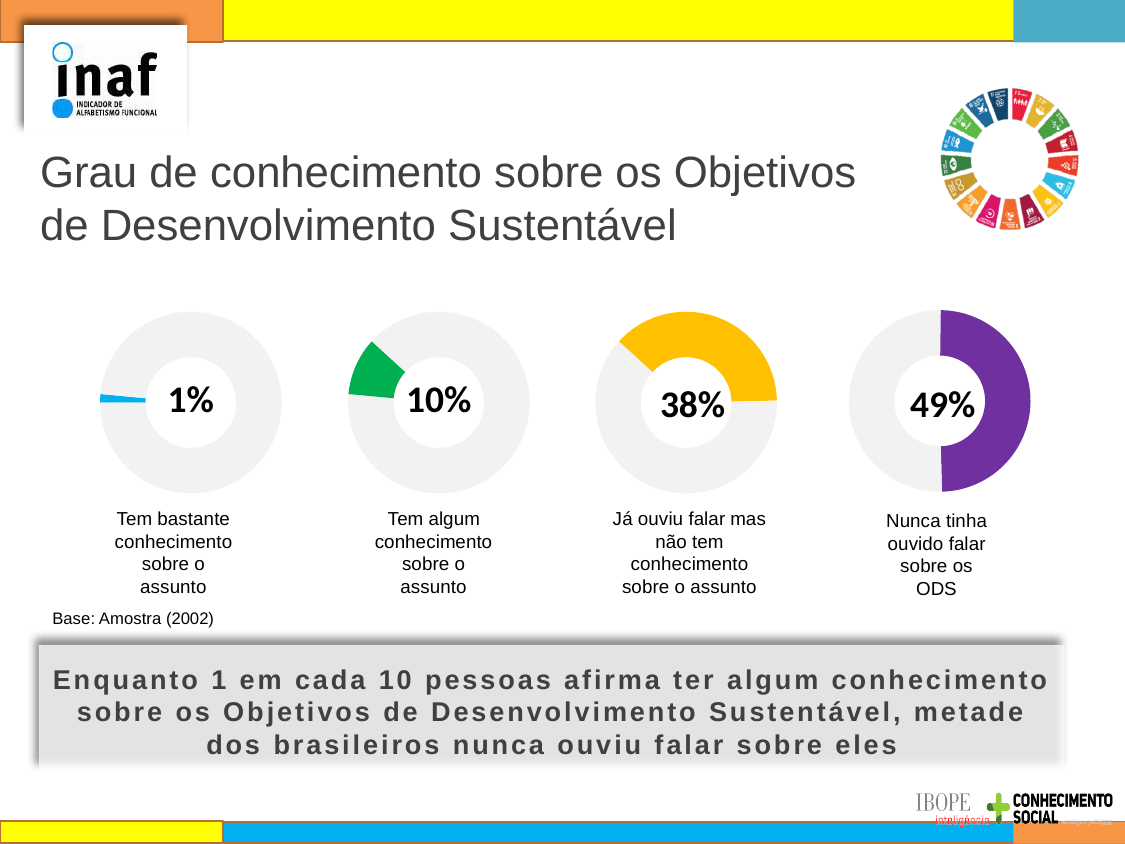
What percentage is shown in the donut chart labelled "Já ouviu falar mas não tem conhecimento sobre o assunto"? 38% What is the difference in percentage points between the "Nunca tinha ouvido falar sobre os ODS" chart and the "Já ouviu falar mas não tem conhecimento sobre o assunto" chart? 11 How many donut charts are shown on the slide? 4 What colour is the filled segment in the donut chart showing 49%? Purple What is the combined percentage of the "Tem bastante conhecimento sobre o assunto" and "Tem algum conhecimento sobre o assunto" charts? 11% What percentage is shown in the donut chart labelled "Nunca tinha ouvido falar sobre os ODS"? 49% Which category has the highest percentage across the four donut charts? Nunca tinha ouvido falar sobre os ODS What kind of chart is used to display the percentages on the slide? Donut chart Which category has the lowest percentage across the four donut charts? Tem bastante conhecimento sobre o assunto Which is larger: the percentage for "Tem algum conhecimento sobre o assunto" or for "Tem bastante conhecimento sobre o assunto"? Tem algum conhecimento sobre o assunto What percentage is shown in the donut chart labelled "Tem algum conhecimento sobre o assunto"? 10% What percentage is shown in the donut chart labelled "Tem bastante conhecimento sobre o assunto"? 1%